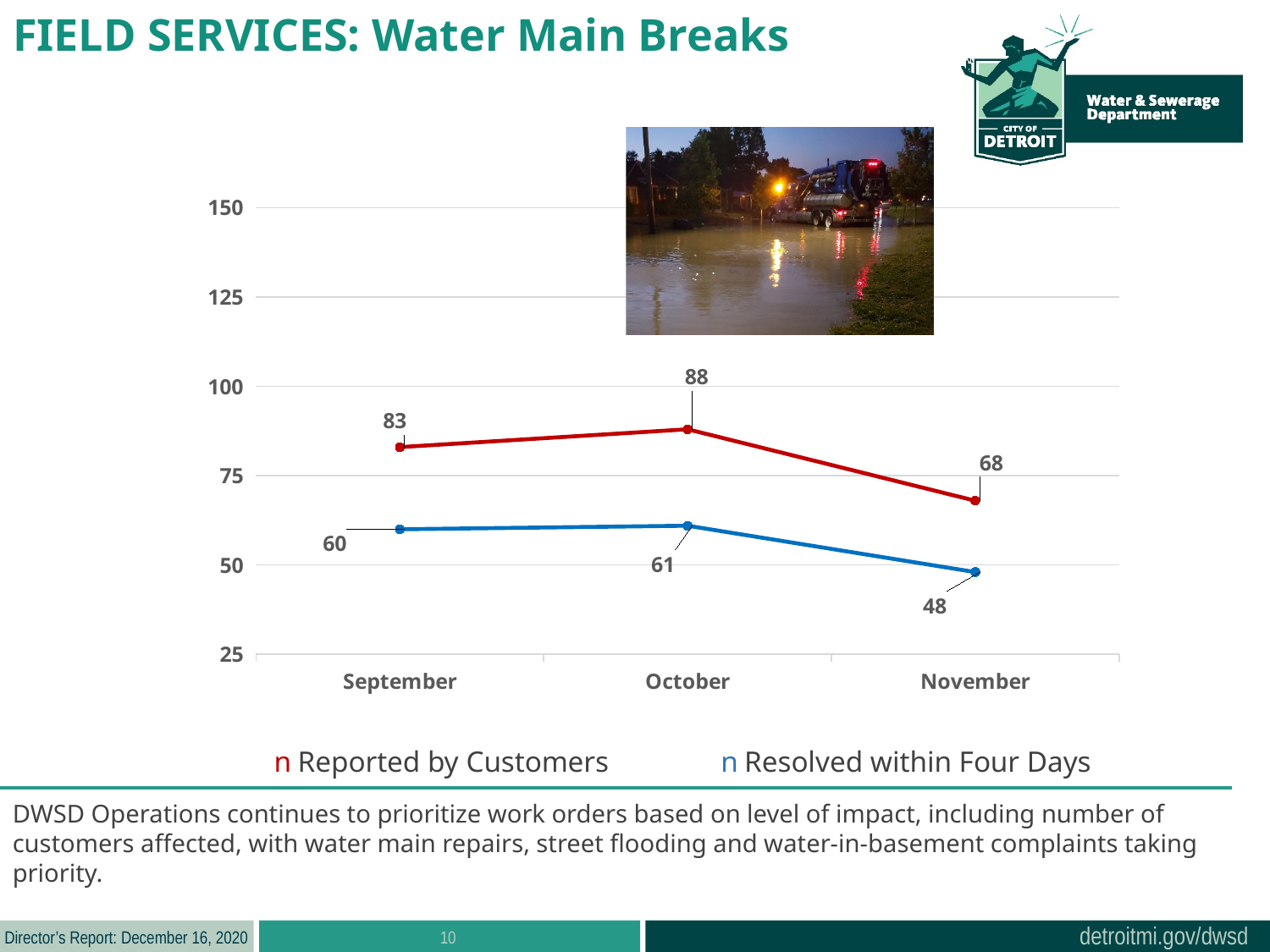
In which month is the Resolved within Four Days value lowest? November How many months are shown on the x axis? 3 Does the Resolved within Four Days series rise or fall from October to November? Fall Which is larger in September: Reported by Customers or Resolved within Four Days? Reported by Customers What is the value for Resolved within Four Days in November? 48 How many series does the legend list? 2 What is the value for Reported by Customers in October? 88 What is the value for Reported by Customers in September? 83 What is the difference between Reported by Customers and Resolved within Four Days in October? 27 What kind of chart is shown on the slide? Line chart In which month is the Reported by Customers value highest? October What is the difference between the Reported by Customers values for October and November? 20